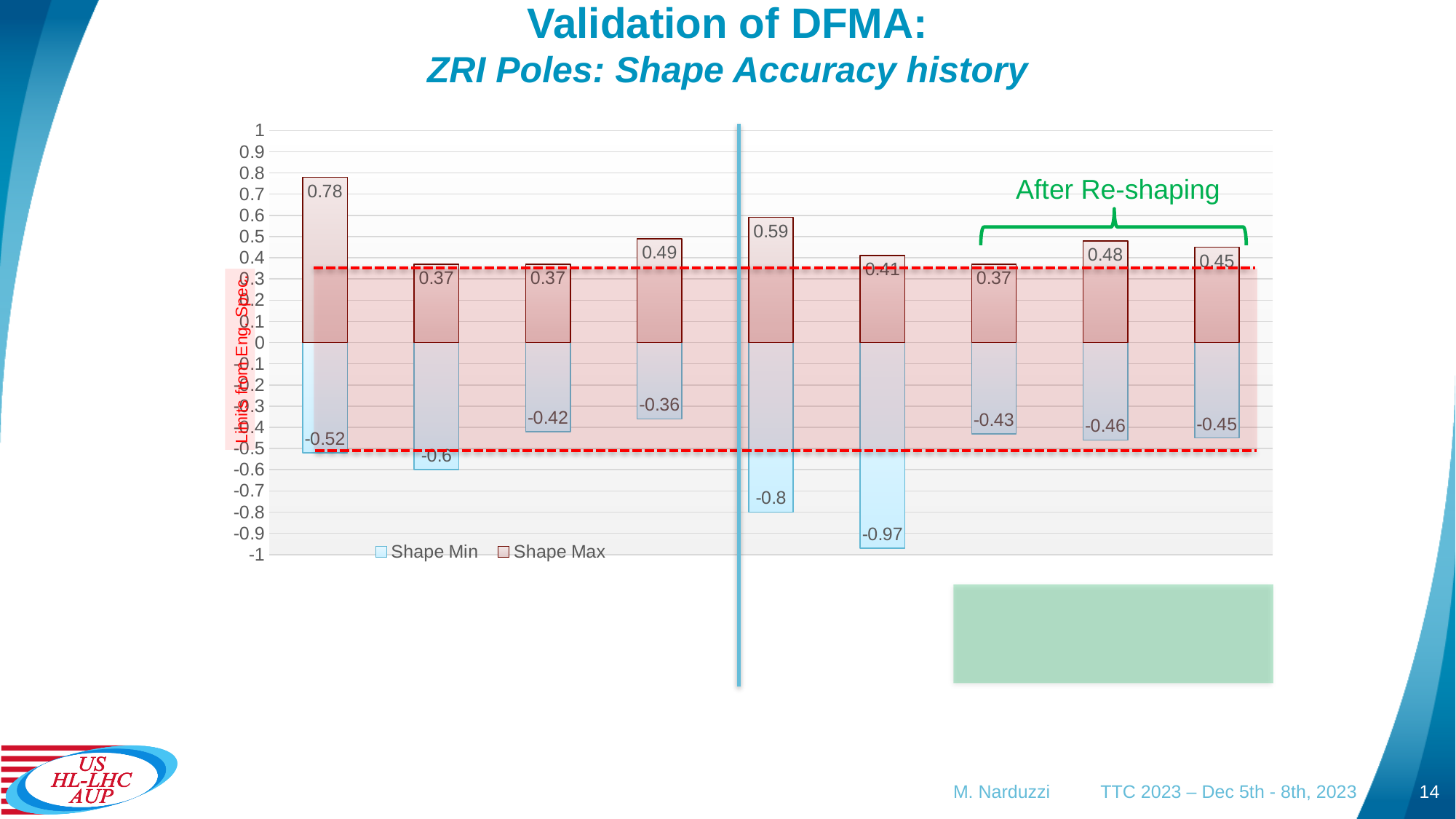
What are the two series named in the legend? Shape Min and Shape Max What is the Shape Max value for the first (leftmost) bar? 0.78 What is the Shape Min value for the fifth bar from the left? -0.8 Which is larger, the Shape Max of the fourth bar from the left or the Shape Max of the eighth bar from the left? the fourth bar (0.49) What is the lowest Shape Min value shown in the chart? -0.97 How many pairs of bars (data points) are plotted in the chart? 9 What is the Shape Min value for the sixth bar from the left? -0.97 What is the highest Shape Max value shown in the chart? 0.78 What is the difference between the Shape Max of the first bar (0.78) and the Shape Max of the fifth bar (0.59)? 0.19 What label is written in green above the last three bars? After Re-shaping How many series does the legend list? 2 What type of chart is shown on the slide? bar chart